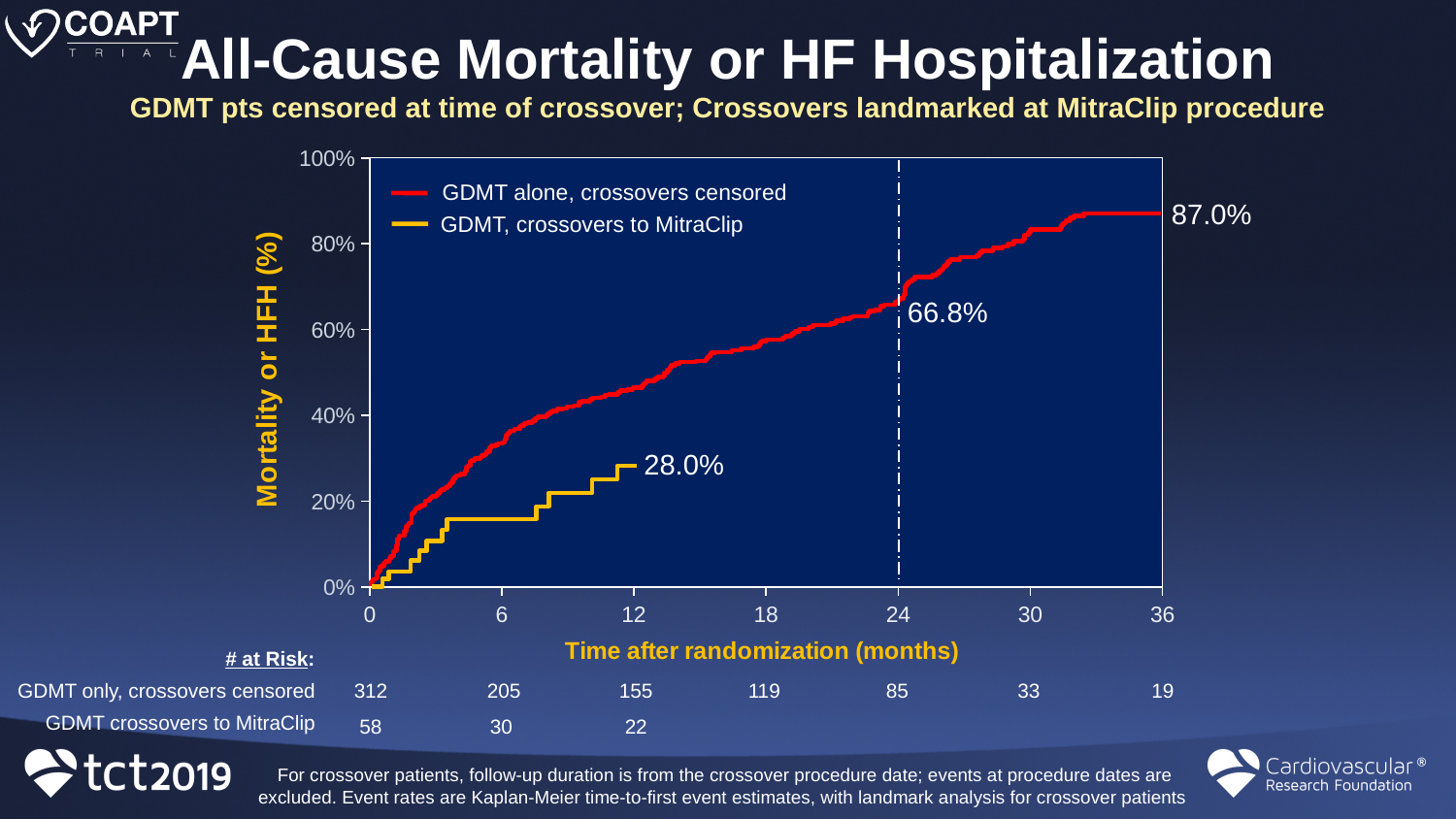
What is the labeled final value of the GDMT, crossovers to MitraClip curve? 28.0% Which curve reaches a higher event rate, GDMT alone, crossovers censored or GDMT, crossovers to MitraClip? GDMT alone, crossovers censored How many patients were at risk in the GDMT only, crossovers censored group at 24 months? 85 What is the difference between the GDMT alone curve's value at 36 months and its value at 24 months? 20.2% What is the labeled value of the GDMT alone, crossovers censored curve at 24 months? 66.8% Is the value of the GDMT, crossovers to MitraClip curve at 6 months greater or less than 20%? less Is the value of the GDMT alone, crossovers censored curve at 12 months greater or less than 40%? greater What is the labeled value of the GDMT alone, crossovers censored curve at 36 months? 87.0% Do the curves rise or fall as time after randomization increases? rise What colour is the GDMT, crossovers to MitraClip curve? Yellow What is the label of the y axis? Mortality or HFH (%) How many series does the legend list? 2